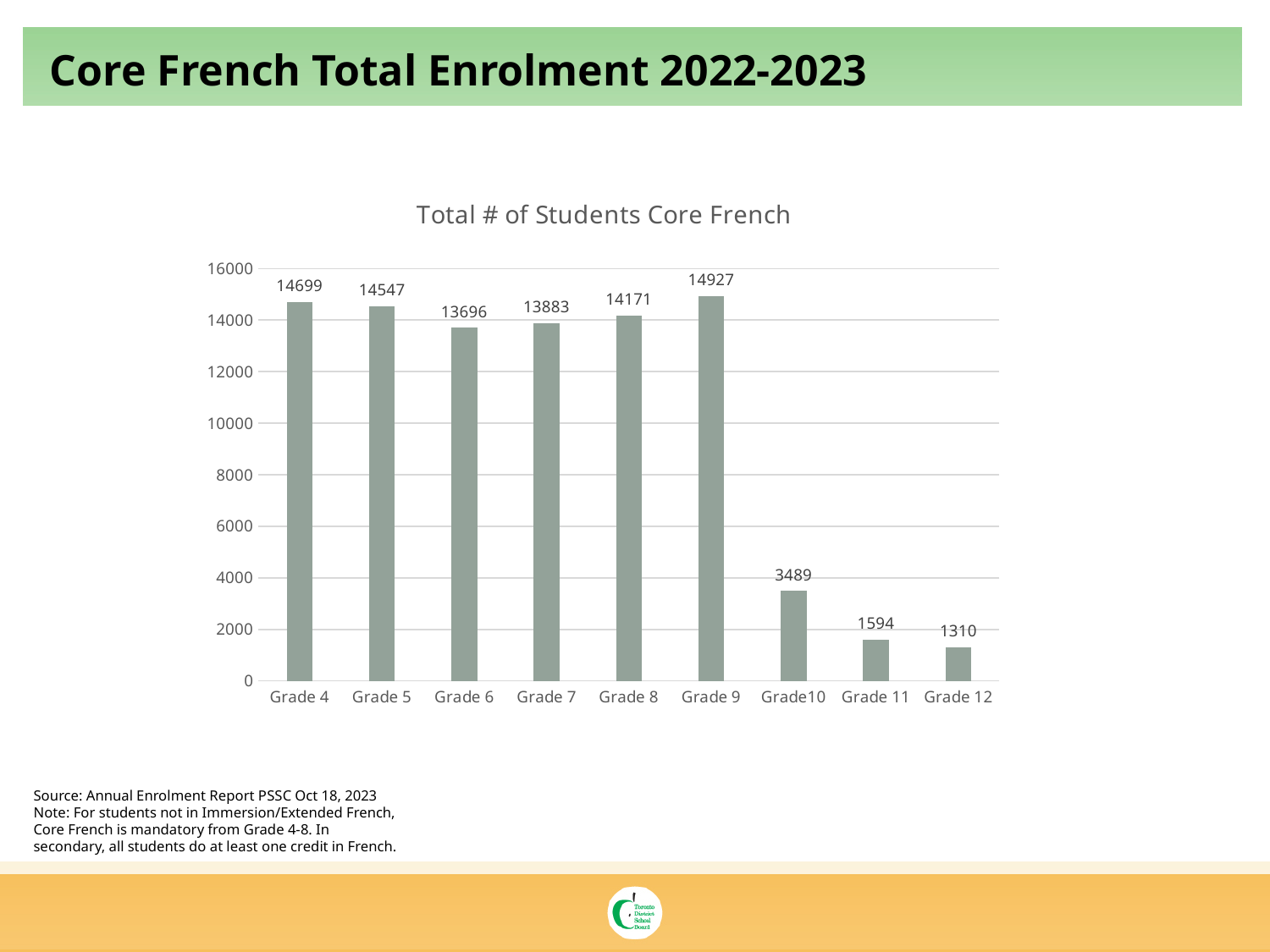
Which has a larger Core French enrolment, Grade 6 or Grade 7? Grade 7 Which grade has the highest Core French enrolment? Grade 9 What is the total number of Core French students in Grade 12? 1310 Is the Core French enrolment for Grade 8 greater or less than 14000? greater What is the title of the chart? Total # of Students Core French What is the total number of Core French students in Grade 4? 14699 What is the total number of Core French students in Grade 10? 3489 Which grade has the lowest Core French enrolment? Grade 12 What is the difference in Core French enrolment between Grade 9 and Grade 10? 11438 What is the difference in Core French enrolment between Grade 11 and Grade 12? 284 How many grades are shown on the chart? 9 What kind of chart is shown on the slide? Bar chart